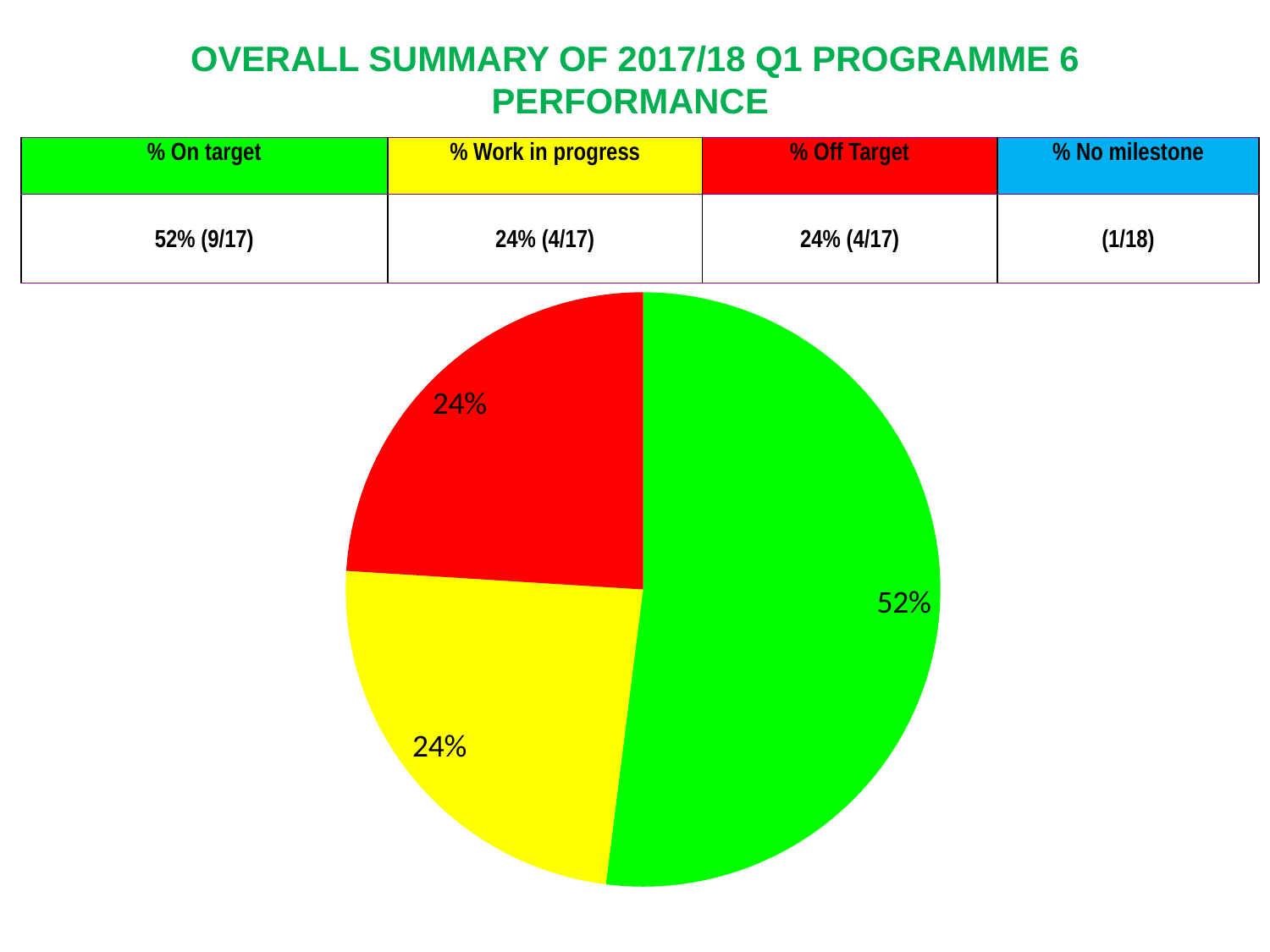
Is the value of the green slice in the pie chart greater or less than 50%? greater What share of the pie does the green slice represent? 52% How many slices does the pie chart have? 3 What is the difference between the green slice and the yellow slice in the pie chart? 28% What percentage is shown on the green slice of the pie chart? 52% What kind of chart is shown on the slide? pie chart What percentage is shown on the yellow slice of the pie chart? 24% What colour is the largest slice of the pie chart? green What do the three labelled slices of the pie chart add up to? 100% Which is larger in the pie chart, the green slice or the red slice? the green slice What percentage is shown on the red slice of the pie chart? 24% Which slice of the pie chart is the largest? the green slice (52%)